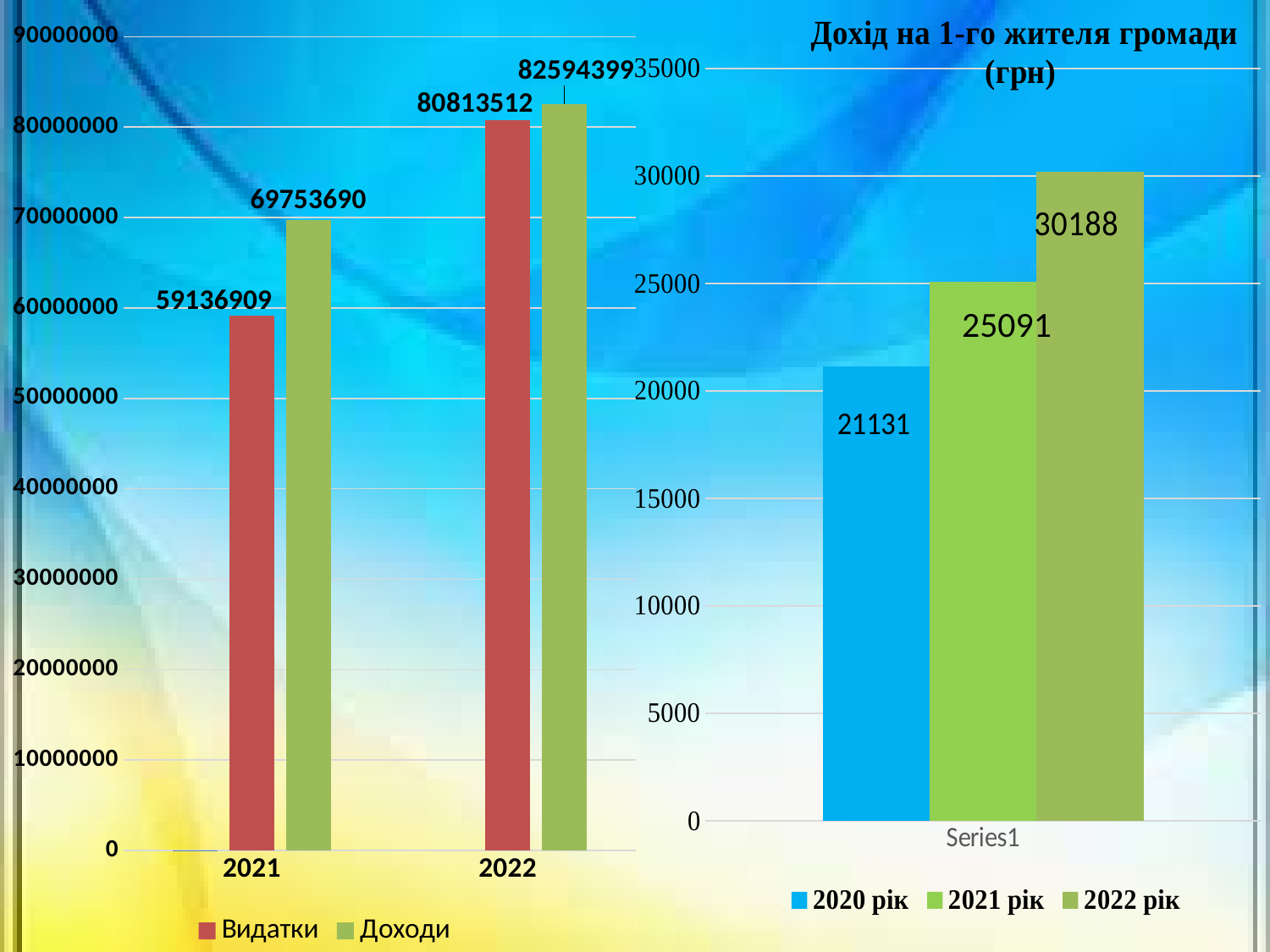
In the chart titled 'Дохід на 1-го жителя громади (грн)', what is the value for 2021 рік? 25091 In the left chart, what is the difference between Доходи and Видатки in 2022? 1780887 In the left chart, what is the value of Доходи for 2022? 82594399 In the chart titled 'Дохід на 1-го жителя громади (грн)', which year has the highest value? 2022 рік In the left chart, how many series does the legend list? 2 In the left chart, what is the value of Видатки for 2021? 59136909 In the chart titled 'Дохід на 1-го жителя громади (грн)', which year has the lowest value? 2020 рік What kind of chart is the chart titled 'Дохід на 1-го жителя громади (грн)'? bar chart In the chart titled 'Дохід на 1-го жителя громади (грн)', what is the difference between the 2022 рік and 2020 рік values? 9057 In the left chart, what is the value of Доходи for 2021? 69753690 In the left chart, do the Видатки values rise or fall from 2021 to 2022? rise In the left chart, what is the difference between Доходи and Видатки in 2021? 10616781